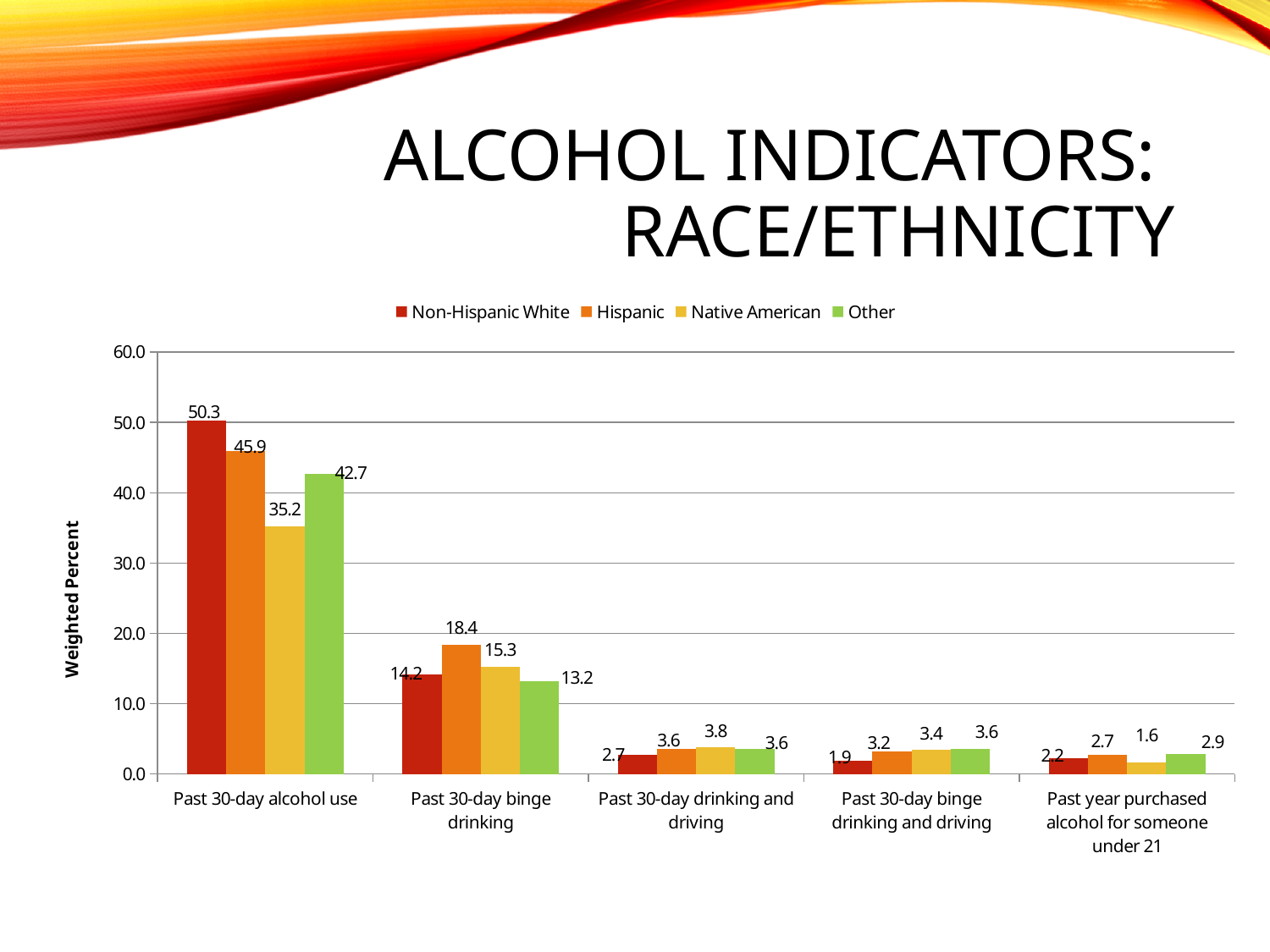
What is the difference between the Non-Hispanic White and Native American values for Past 30-day alcohol use? 15.1 What is the value for Hispanic for Past 30-day binge drinking? 18.4 What is the value for Other for Past 30-day binge drinking and driving? 3.6 How many series does the legend list? 4 Which is larger for Past 30-day binge drinking: the Hispanic value or the Other value? Hispanic How many categories are shown on the x axis? 5 Which race/ethnicity group has the highest value for Past 30-day alcohol use? Non-Hispanic White Which race/ethnicity group has the lowest value for Past 30-day binge drinking and driving? Non-Hispanic White What is the label of the vertical axis? Weighted Percent What is the value for Native American for Past year purchased alcohol for someone under 21? 1.6 What kind of chart is shown on the slide? Bar chart What is the value for Non-Hispanic White for Past 30-day alcohol use? 50.3